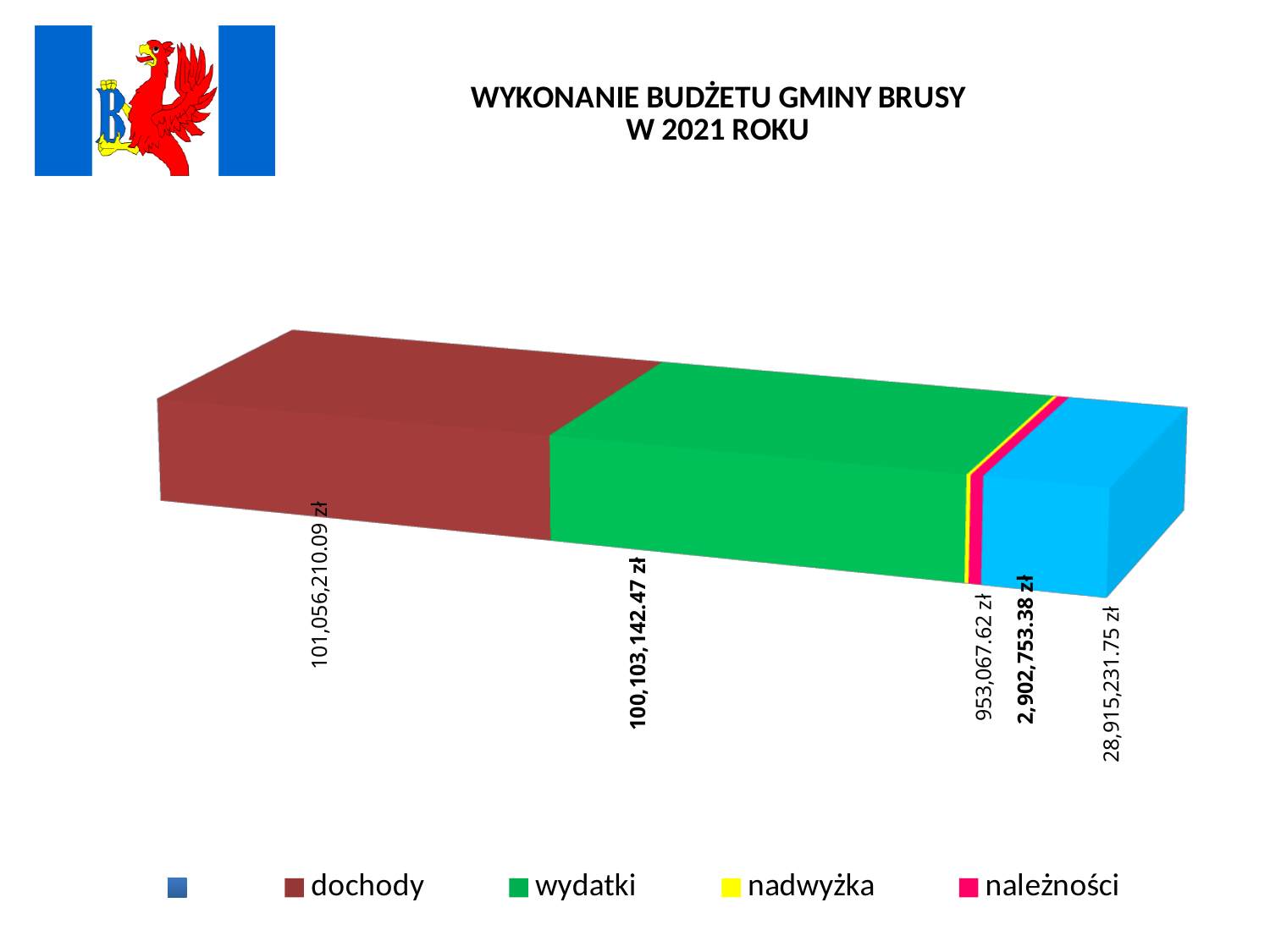
What colour is the wydatki segment? green Which is larger, należności or nadwyżka? należności What is the value for wydatki? 100,103,142.47 zł What is the difference between dochody and wydatki? 953,067.62 zł How many segments make up the stacked bar? 5 What is the value for należności? 2,902,753.38 zł What is the value for nadwyżka? 953,067.62 zł What is the difference between należności and nadwyżka? 1,949,685.76 zł What kind of chart is shown on the slide? bar chart Which labelled category has the highest value? dochody What is the value for dochody? 101,056,210.09 zł Which labelled category has the lowest value? nadwyżka